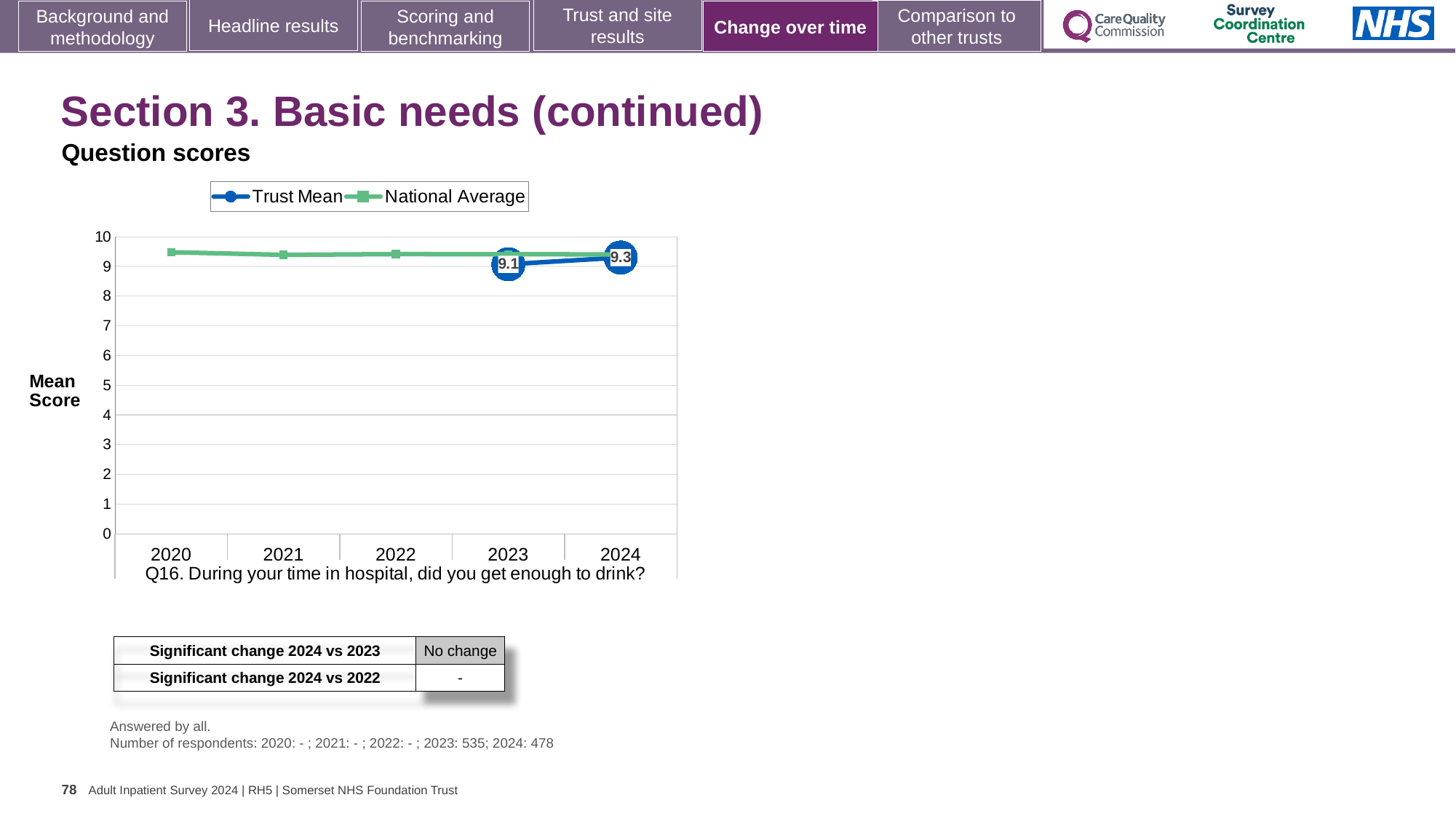
What kind of chart is shown on the slide? line chart How many years are shown on the x axis? 5 In which year is the Trust Mean score highest? 2024 Does the Trust Mean score rise or fall from 2023 to 2024? rise Is the National Average score for 2020 greater or less than 9? greater In which year is the Trust Mean score lowest? 2023 What is the Trust Mean score for 2023? 9.1 What is the difference between the Trust Mean scores for 2024 and 2023? 0.2 What is the Trust Mean score for 2024? 9.3 What is the label of the y axis? Mean Score Which is larger, the Trust Mean score for 2023 or for 2024? 2024 How many series does the legend list? 2